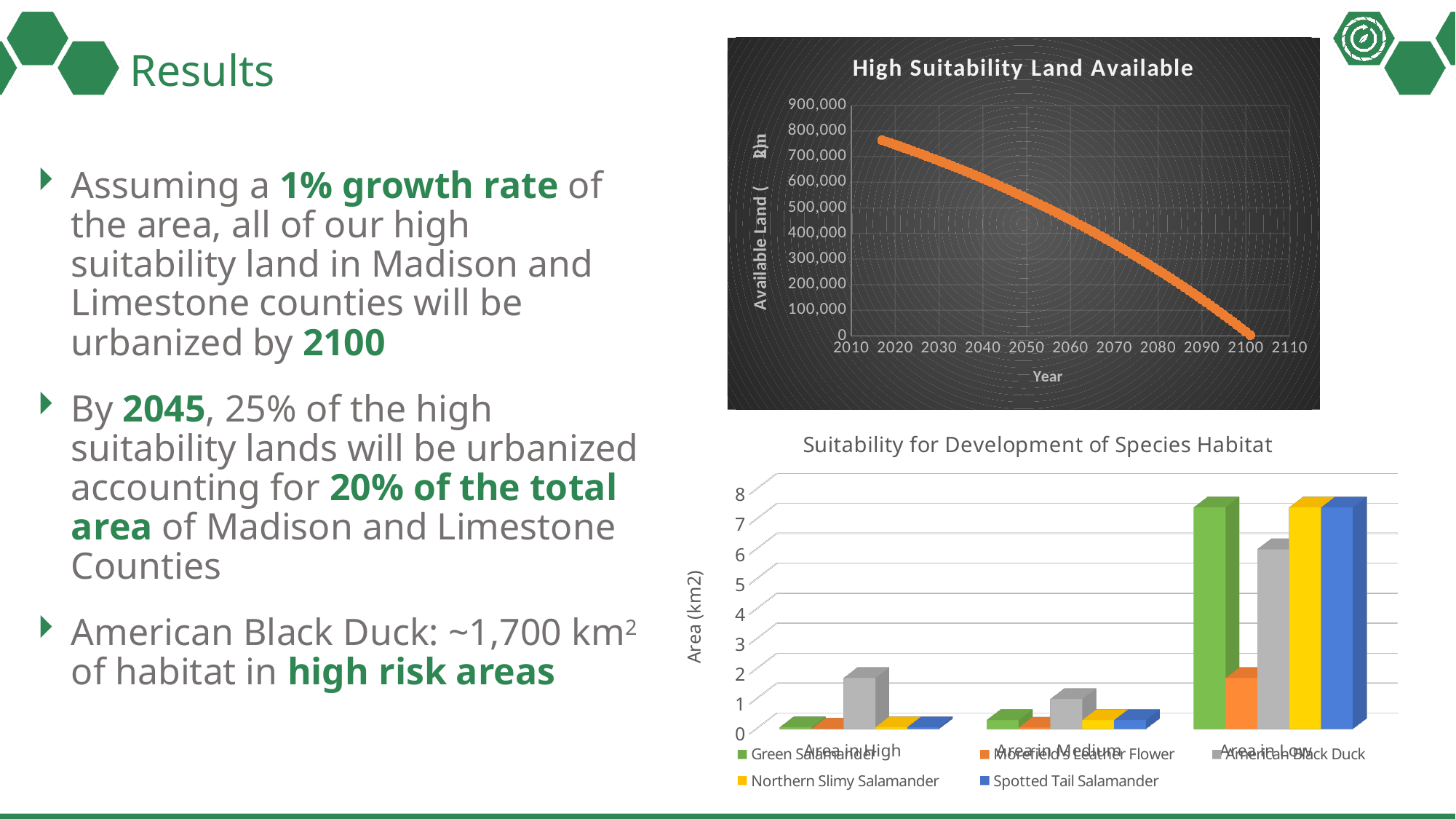
How many series does the legend of the 'Suitability for Development of Species Habitat' chart list? 5 In the 'High Suitability Land Available' chart, is the available land in 2100 greater or less than 100,000? less What kind of chart is the 'Suitability for Development of Species Habitat' chart? bar chart What kind of chart is the 'High Suitability Land Available' chart? line chart In the 'Suitability for Development of Species Habitat' chart, for Area in Low, which is larger: American Black Duck or Morefield's Leather Flower? American Black Duck In the 'Suitability for Development of Species Habitat' chart, which species has the lowest value for Area in Low? Morefield's Leather Flower What is the x-axis label of the 'High Suitability Land Available' chart? Year In the 'High Suitability Land Available' chart, does the available land rise or fall as the year increases? fall How many categories are shown on the x axis of the 'Suitability for Development of Species Habitat' chart? 3 In the 'Suitability for Development of Species Habitat' chart, which species has the highest value for Area in High? American Black Duck In the 'High Suitability Land Available' chart, is the available land in 2080 greater or less than 300,000? less In the 'High Suitability Land Available' chart, is the available land in 2020 greater or less than 700,000? greater